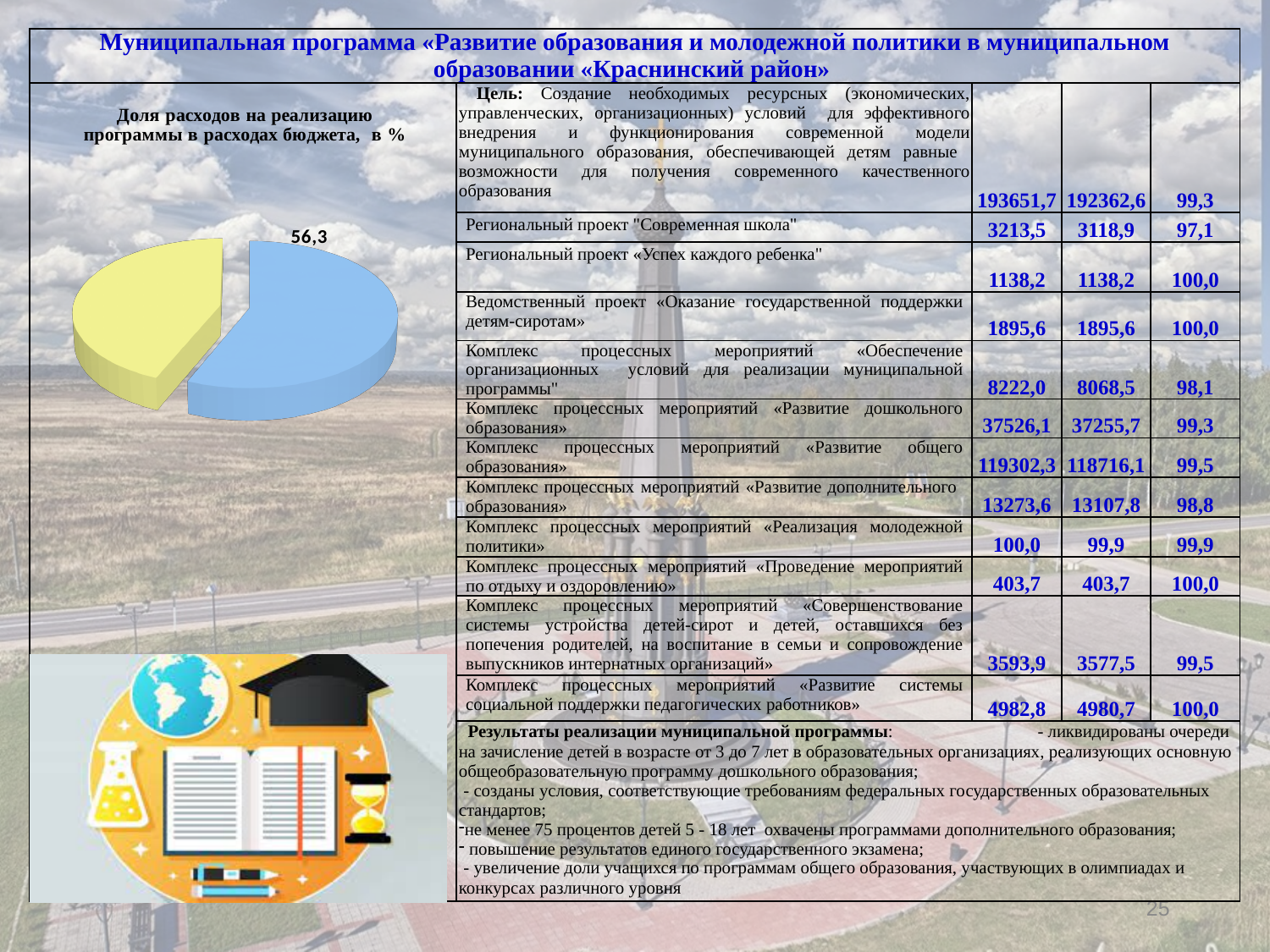
What colour is the slice of the pie chart that carries the data label? blue Which slice of the pie chart is the smallest? the yellow slice How many slices does the pie chart have? 2 What is the title of the pie chart on the slide? Доля расходов на реализацию программы в расходах бюджета, в % What kind of chart is shown on the left of the slide? pie chart Which slice of the pie chart is larger, the blue one or the yellow one? the blue one What value is printed on the blue slice of the pie chart? 56,3 What share of the pie does the blue slice represent? 56,3